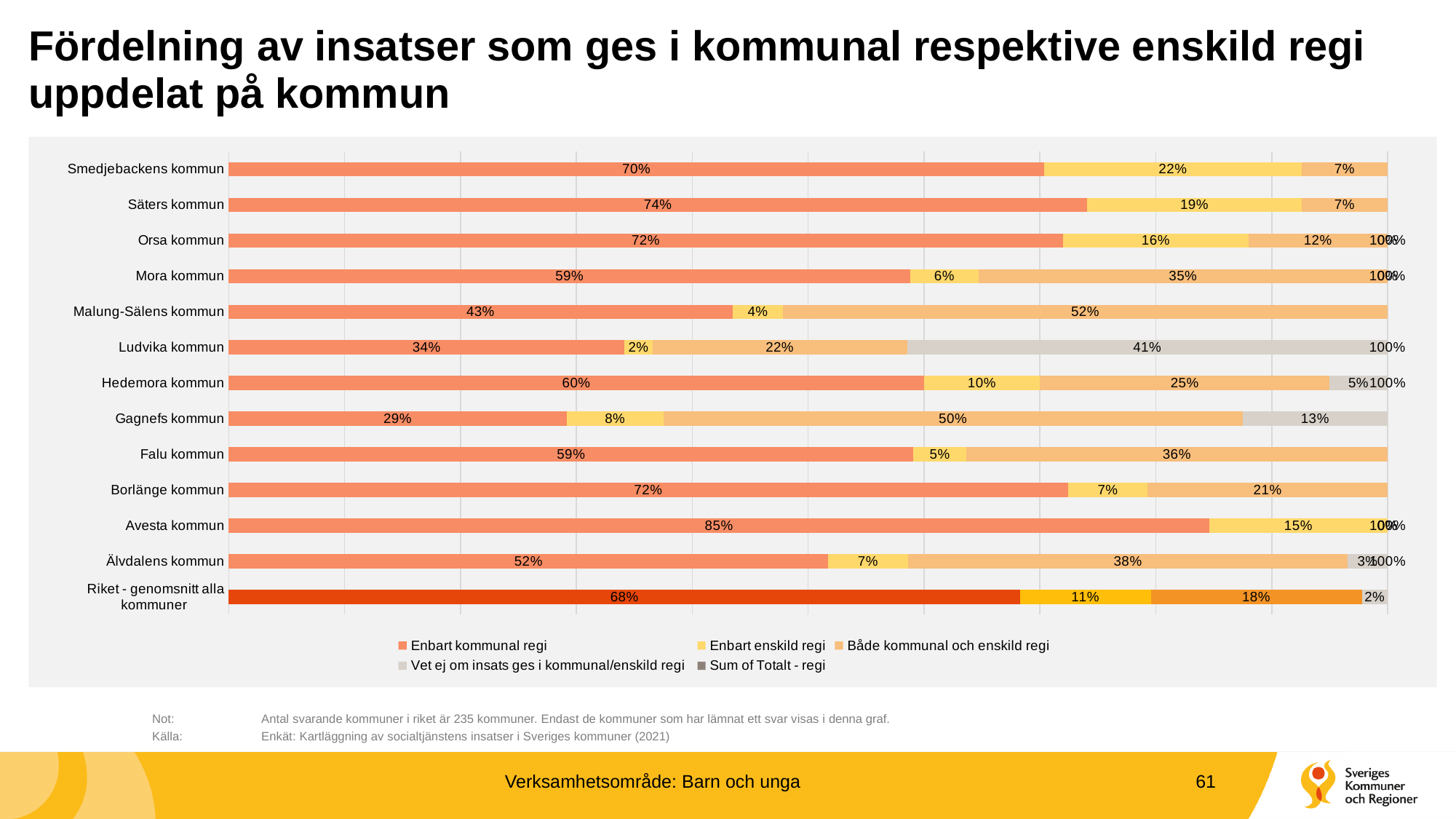
How many series does the legend list? 5 What is the value of 'Enbart kommunal regi' for Avesta kommun? 85% What is the value of 'Vet ej om insats ges i kommunal/enskild regi' for Ludvika kommun? 41% What is the value of 'Enbart kommunal regi' for 'Riket - genomsnitt alla kommuner'? 68% Which has a larger value for 'Enbart enskild regi', Smedjebackens kommun or Säters kommun? Smedjebackens kommun How many categories (rows) are shown on the chart? 13 Which municipality has the highest value for 'Enbart kommunal regi'? Avesta kommun Which municipality has the highest value for 'Vet ej om insats ges i kommunal/enskild regi'? Ludvika kommun What is the difference in 'Enbart kommunal regi' between Säters kommun and Smedjebackens kommun? 4 percentage points What kind of chart is shown on the slide? Stacked bar chart Which municipality has the lowest value for 'Enbart kommunal regi'? Gagnefs kommun What is the value of 'Både kommunal och enskild regi' for Malung-Sälens kommun? 52%